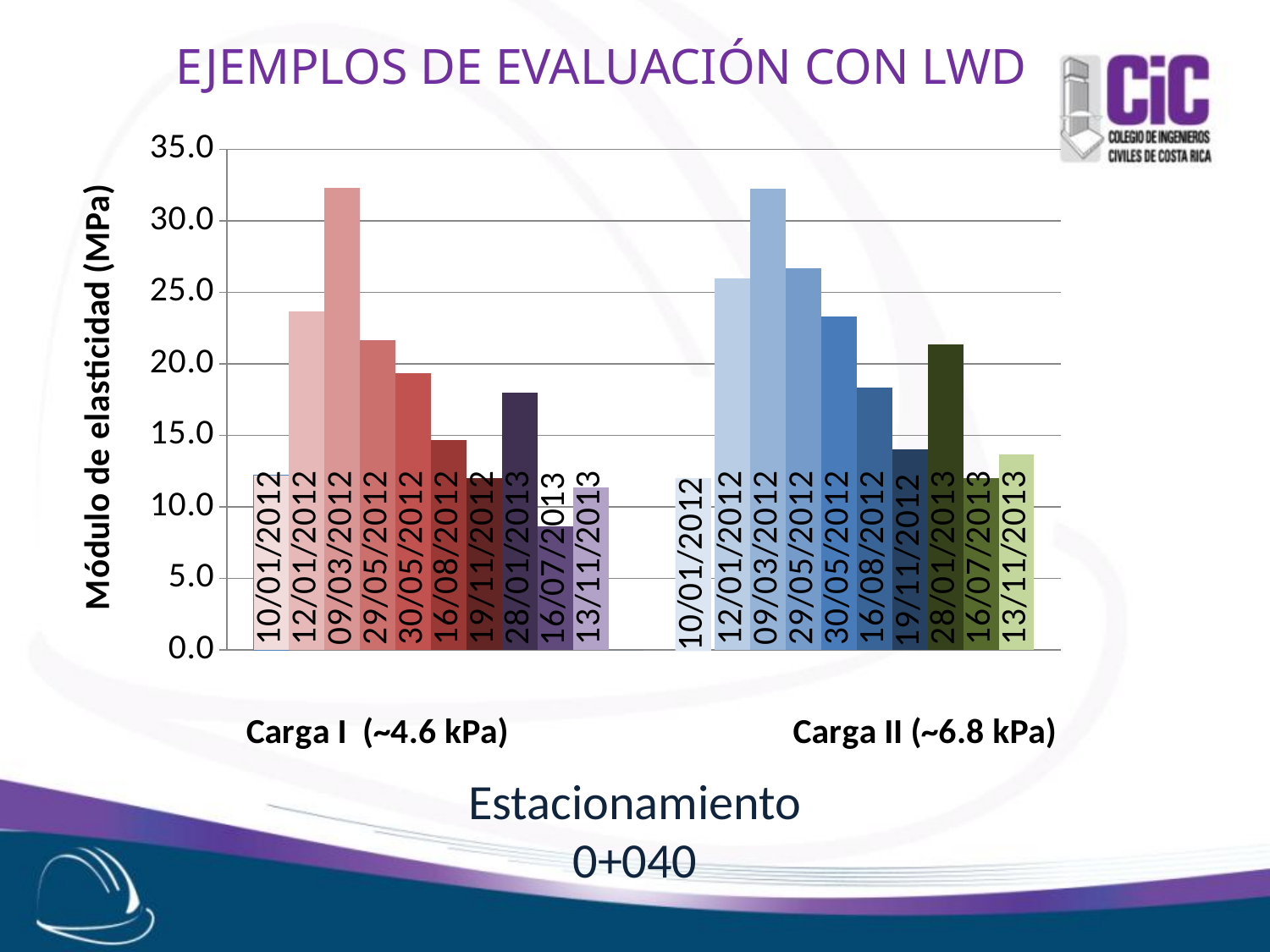
What is the label of the vertical axis? Módulo de elasticidad (MPa) What are the two load groups labelled below the chart? Carga I (~4.6 kPa) and Carga II (~6.8 kPa) In the Carga I (~4.6 kPa) group, which date has the highest modulus of elasticity? 09/03/2012 In the Carga I group, which is larger: the value for 12/01/2012 or the value for 29/05/2012? 12/01/2012 How many dates are plotted in each load group? 10 Is the value for 16/07/2013 in the Carga I group greater or less than 10.0? less In the Carga II group, which is larger: the value for 28/01/2013 or the value for 19/11/2012? 28/01/2013 Is the value for 28/01/2013 in the Carga I group greater or less than 15.0? greater What kind of chart is shown on the slide? bar chart Is the value for 30/05/2012 in the Carga II group greater or less than 20.0? greater In the Carga II (~6.8 kPa) group, which date has the highest modulus of elasticity? 09/03/2012